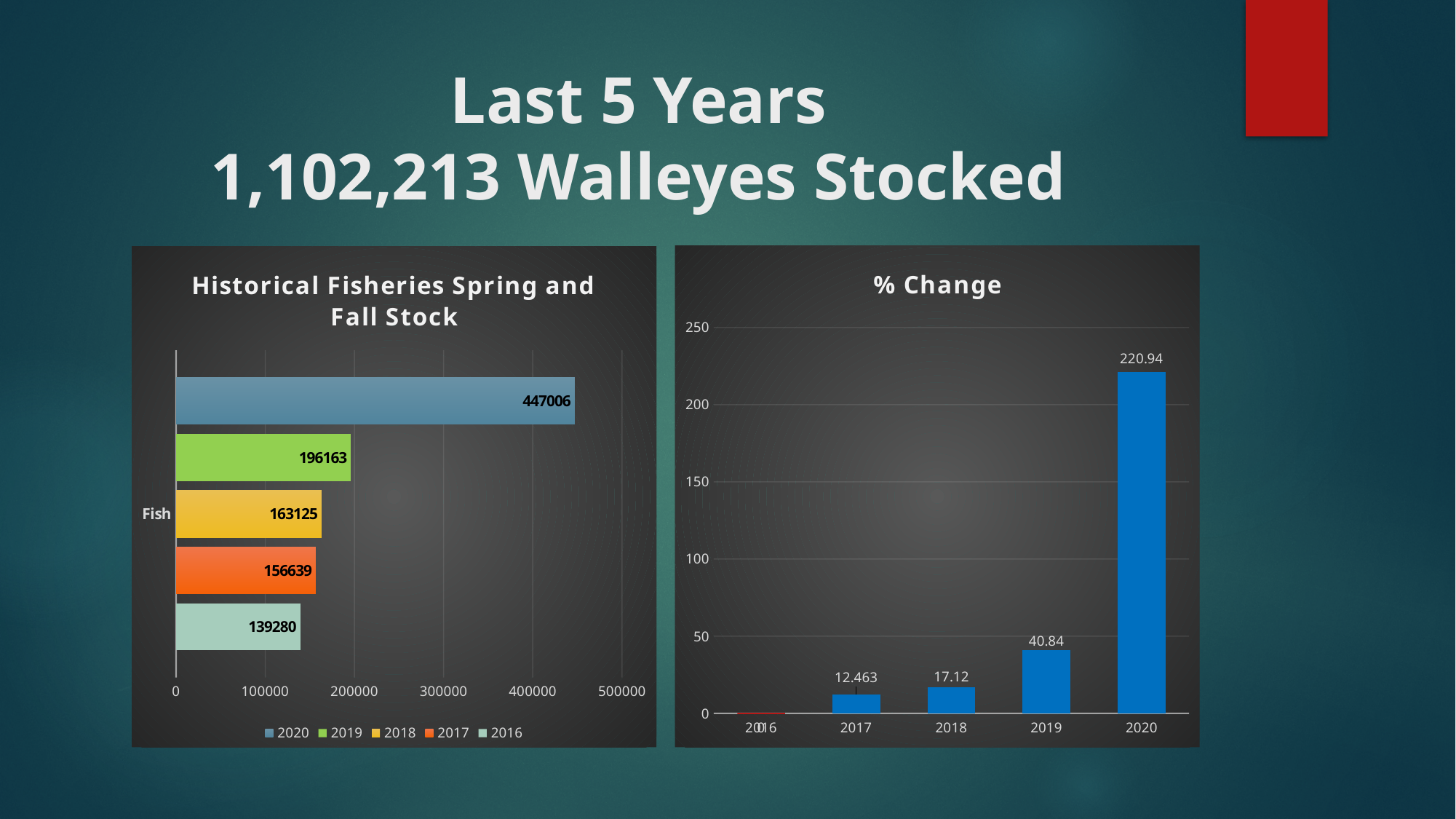
In the '% Change' chart, which year has the highest value? 2020 In the 'Historical Fisheries Spring and Fall Stock' chart, which year has the lowest value? 2016 In the 'Historical Fisheries Spring and Fall Stock' chart, what is the value for 2020? 447006 In the '% Change' chart, what is the value for 2019? 40.84 In the '% Change' chart, do the values rise or fall from 2016 to 2020? Rise In the '% Change' chart, what is the value for 2017? 12.463 In the '% Change' chart, is the value for 2020 greater or less than 200? greater In the 'Historical Fisheries Spring and Fall Stock' chart, how many series does the legend list? 5 In the 'Historical Fisheries Spring and Fall Stock' chart, which year has the highest value? 2020 In the 'Historical Fisheries Spring and Fall Stock' chart, what is the difference between the 2019 and 2018 values? 33038 What kind of chart is the 'Historical Fisheries Spring and Fall Stock' chart? Bar chart In the 'Historical Fisheries Spring and Fall Stock' chart, what is the value for 2016? 139280